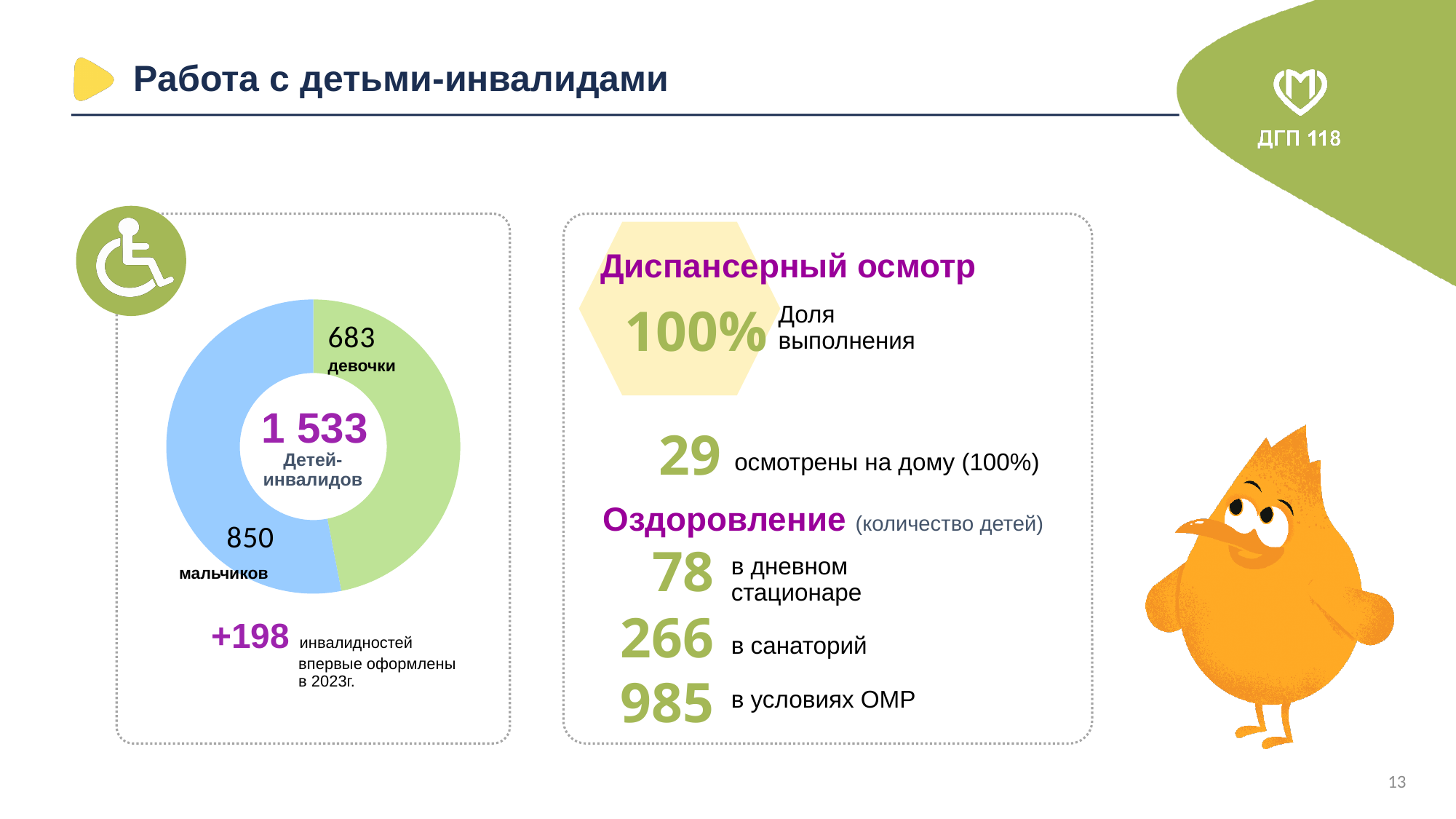
How many children are in the 'девочки' segment of the donut chart? 683 Which category has the lowest value in the donut chart? девочки Which category has the highest value in the donut chart? мальчиков What label is written in the centre of the donut chart below the total? Детей-инвалидов Is the value for 'мальчиков' in the donut chart greater or less than 800? greater How many children are in the 'мальчиков' segment of the donut chart? 850 Which segment of the donut chart is larger, 'девочки' or 'мальчиков'? мальчиков What type of chart is shown on the slide? Pie (donut) chart What is the difference between the number of 'мальчиков' and 'девочки' in the donut chart? 167 What colour is the 'девочки' segment of the donut chart? Green How many segments does the donut chart have? 2 What total number is shown in the centre of the donut chart? 1 533